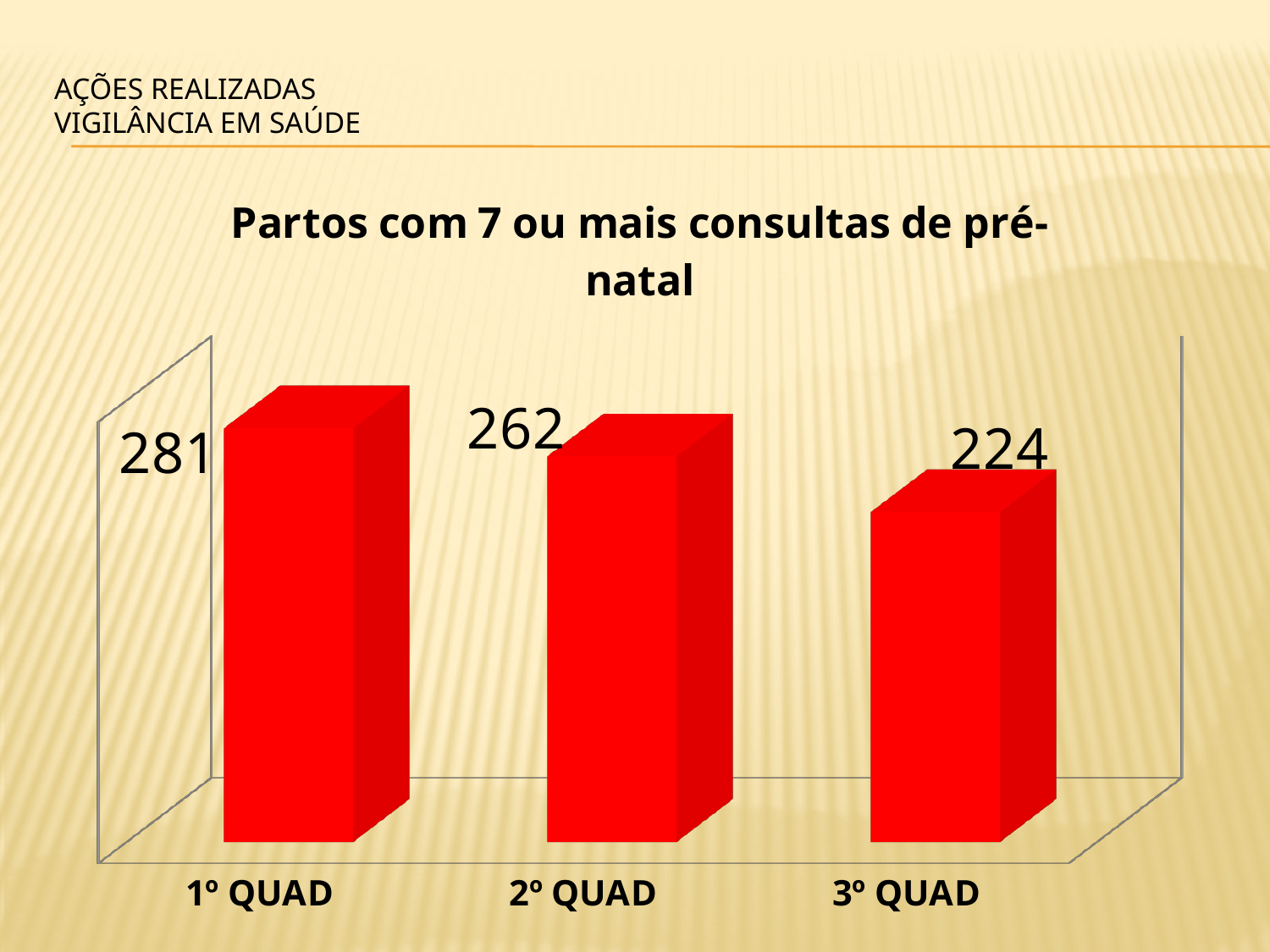
How many categories are shown on the chart? 3 What is the difference between the values for 1º QUAD and 2º QUAD? 19 Which category has the lowest value? 3º QUAD What is the title of the chart? Partos com 7 ou mais consultas de pré-natal Which is larger, the value for 2º QUAD or the value for 3º QUAD? 2º QUAD What kind of chart is shown on the slide? Bar chart What is the difference between the values for 1º QUAD and 3º QUAD? 57 What is the value for 2º QUAD? 262 Which category has the highest value? 1º QUAD What is the value for 1º QUAD? 281 Do the values rise or fall from 1º QUAD to 3º QUAD? Fall What is the value for 3º QUAD? 224